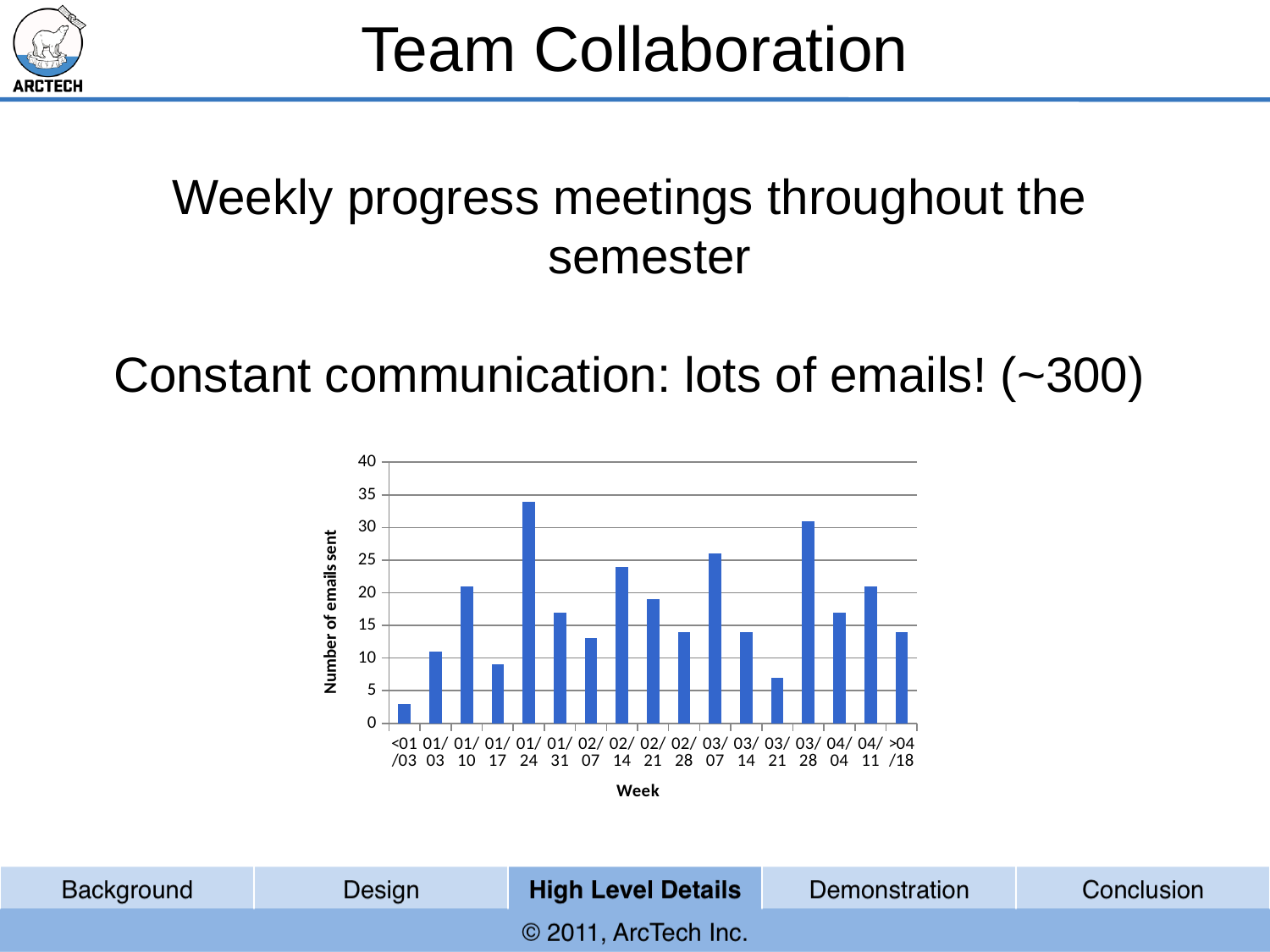
What is the label of the vertical axis of the chart? Number of emails sent Is the number of emails sent in the week of 03/28 greater or less than 25? greater Is the number of emails sent in the week of 02/07 greater or less than 15? less Which week had more emails sent, 01/24 or 03/28? 01/24 What kind of chart is shown on the slide? bar chart Is the number of emails sent in the week of <01/03 greater or less than 5? less How many weeks (bars) are plotted on the chart? 17 Which week has the highest number of emails sent? 01/24 Which week had more emails sent, 01/10 or 01/17? 01/10 Which week has the lowest number of emails sent? <01/03